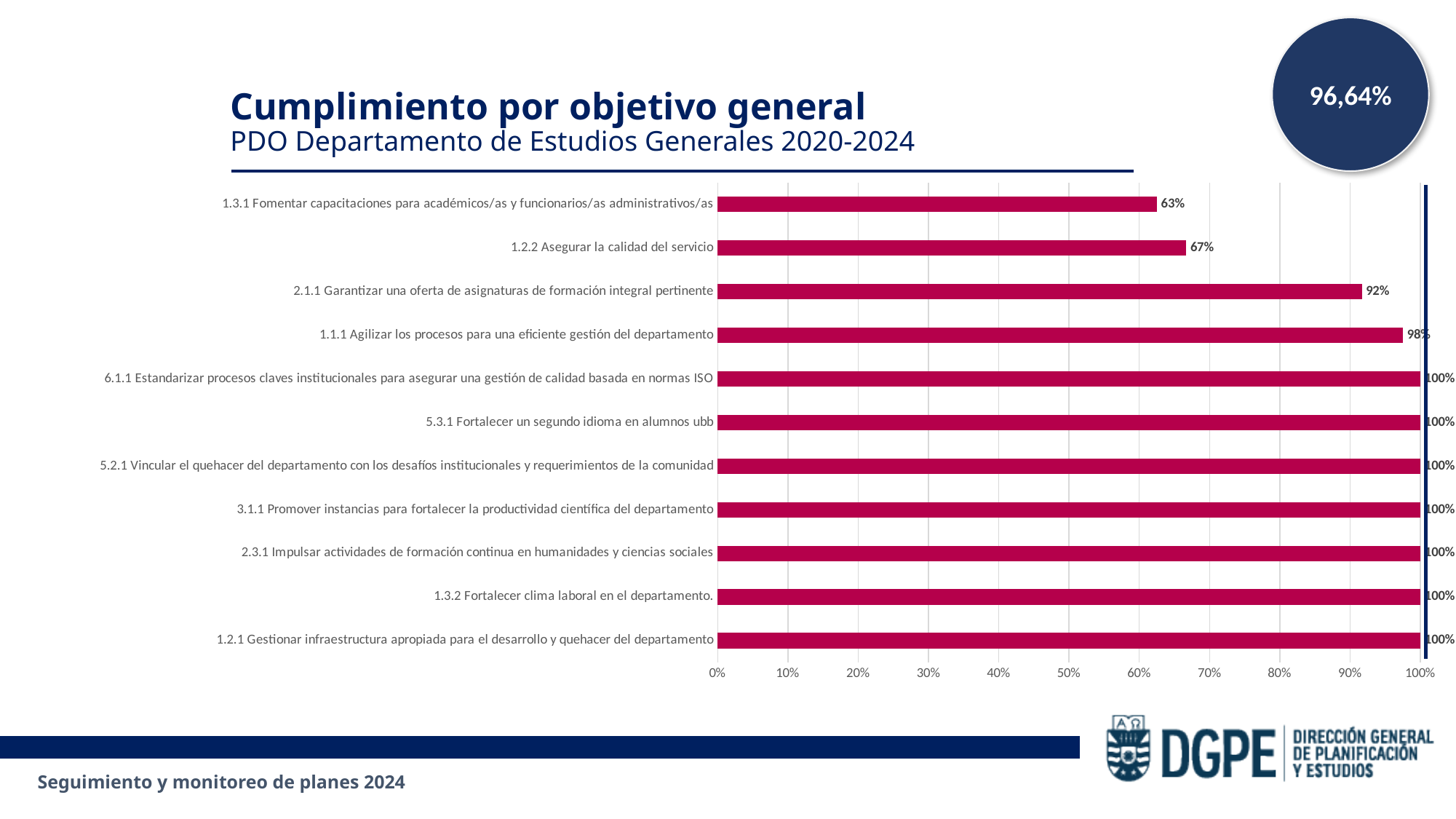
What percentage is shown in the circle at the top right of the slide? 96,64% What kind of chart is shown on the slide? bar chart How many objectives are shown in the chart? 11 Which objective has the lowest value? 1.3.1 Fomentar capacitaciones para académicos/as y funcionarios/as administrativos/as What is the value for 1.1.1 Agilizar los procesos para una eficiente gestión del departamento? 98% How many objectives have a value of 100%? 7 Is the value for 1.2.2 Asegurar la calidad del servicio greater or less than 70%? less What is the value for 2.1.1 Garantizar una oferta de asignaturas de formación integral pertinente? 92% What is the value for 1.3.1 Fomentar capacitaciones para académicos/as y funcionarios/as administrativos/as? 63% What is the difference between the values for 2.1.1 Garantizar una oferta de asignaturas de formación integral pertinente and 1.2.2 Asegurar la calidad del servicio? 25% Which is larger, the value for 1.1.1 Agilizar los procesos para una eficiente gestión del departamento or the value for 2.1.1 Garantizar una oferta de asignaturas de formación integral pertinente? 1.1.1 Agilizar los procesos para una eficiente gestión del departamento What is the value for 1.2.2 Asegurar la calidad del servicio? 67%